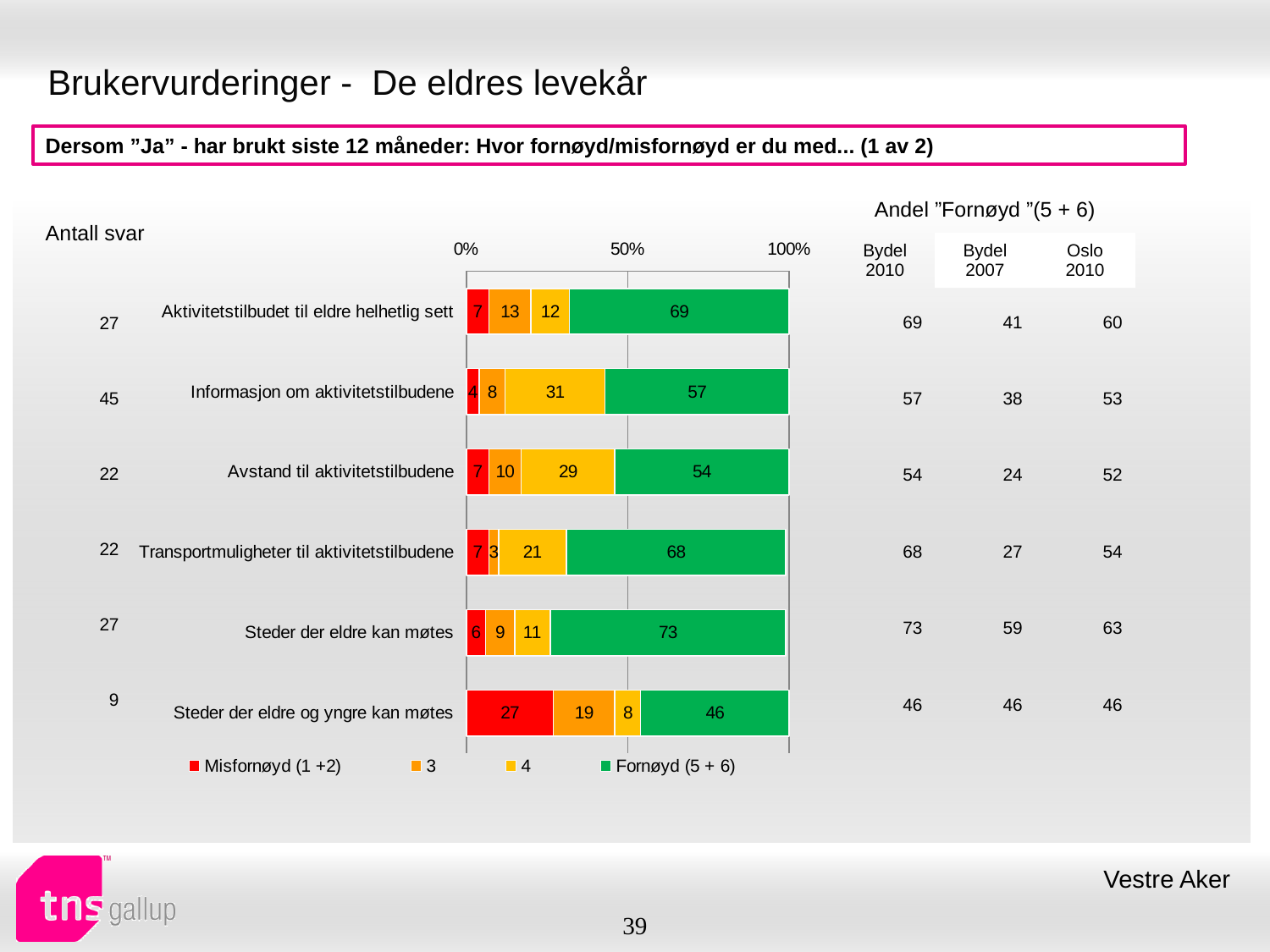
What is the value of the '4' segment for Informasjon om aktivitetstilbudene? 31 How many series does the legend list? 4 What is the value of the Fornøyd (5 + 6) segment for Aktivitetstilbudet til eldre helhetlig sett? 69 What is the value of the Misfornøyd (1 +2) segment for Steder der eldre og yngre kan møtes? 27 What is the first legend entry of the chart? Misfornøyd (1 +2) How many categories are shown in the bar chart? 6 What is the total of the stacked bar for Informasjon om aktivitetstilbudene? 100 What kind of chart is shown on the slide? Stacked bar chart Which has a larger Fornøyd (5 + 6) value: Transportmuligheter til aktivitetstilbudene or Informasjon om aktivitetstilbudene? Transportmuligheter til aktivitetstilbudene Which category has the highest Fornøyd (5 + 6) value? Steder der eldre kan møtes Which category has the lowest Fornøyd (5 + 6) value? Steder der eldre og yngre kan møtes What is the difference between the Fornøyd (5 + 6) values for Steder der eldre kan møtes and Avstand til aktivitetstilbudene? 19